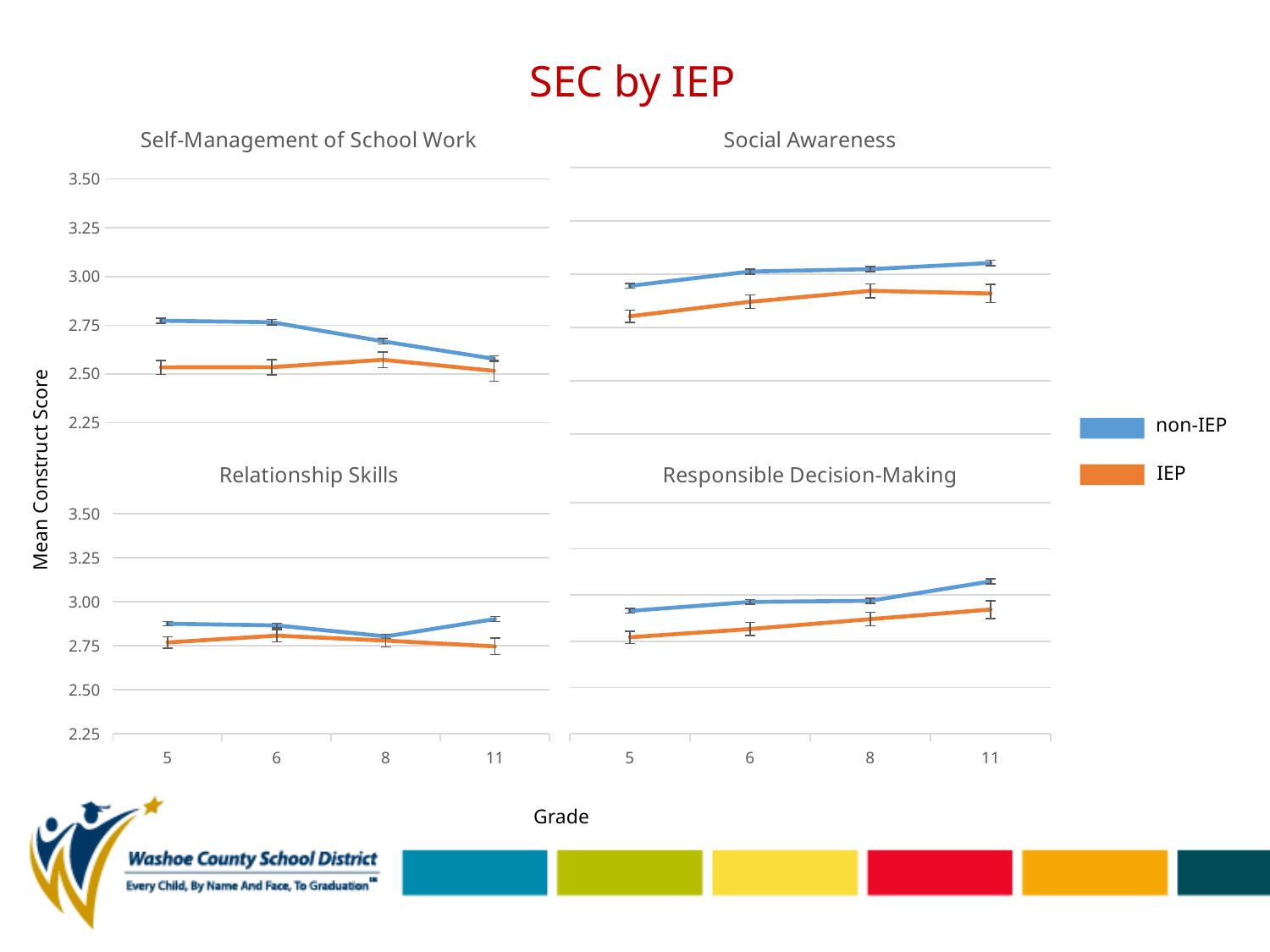
What is the label on the shared y axis of the charts? Mean Construct Score In the Social Awareness chart, is the non-IEP value at grade 11 greater or less than 3.00? greater How many series does the legend list? 2 In the Responsible Decision-Making chart, at which grade is the non-IEP value highest? 11 How many grade levels are plotted on the x axis of the Social Awareness chart? 4 In the Self-Management of School Work chart, does the non-IEP line rise or fall from grade 5 to grade 11? fall In the Social Awareness chart, which series has the larger value at grade 5, non-IEP or IEP? non-IEP In the Self-Management of School Work chart, at which grade is the non-IEP value lowest? 11 In the Self-Management of School Work chart, is the IEP value at grade 5 greater or less than 2.75? less In the Responsible Decision-Making chart, does the IEP line rise or fall from grade 5 to grade 11? rise What kind of chart is the Self-Management of School Work chart? line chart In the Relationship Skills chart, is the non-IEP value at grade 11 greater or less than 3.00? less